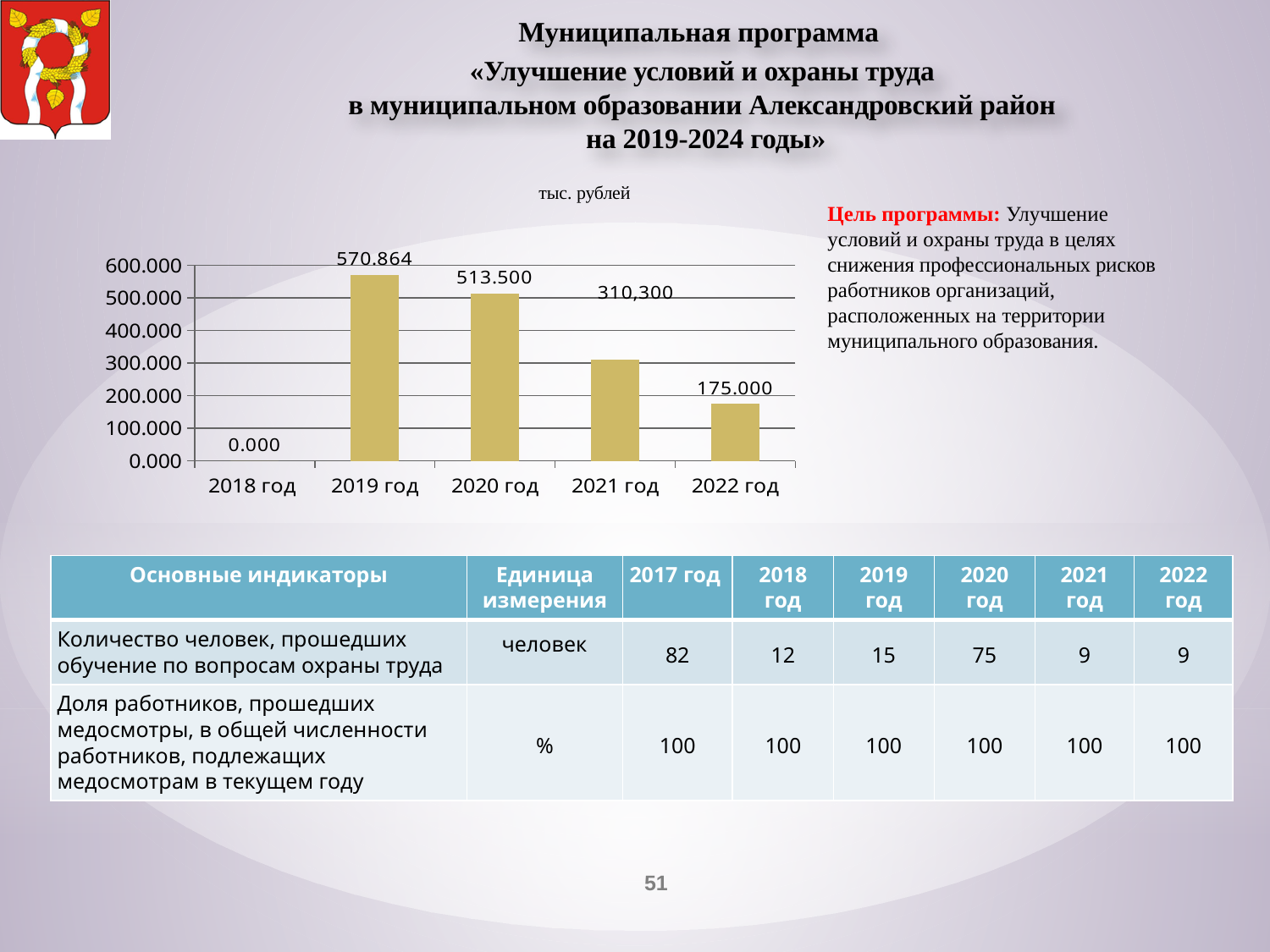
What unit is indicated above the chart? тыс. рублей How many years are shown on the x axis of the chart? 5 Which year has the highest value in the chart? 2019 год What is the value for 2019 год in the chart? 570.864 What kind of chart is shown on the slide? bar chart What is the value for 2020 год in the chart? 513.500 What is the difference between the values for 2019 год and 2020 год? 57.364 Is the value for 2022 год greater or less than 200.000? less What is the value for 2022 год in the chart? 175.000 Which year has the lowest value in the chart? 2018 год Which is larger, the value for 2020 год or the value for 2021 год? 2020 год What is the value for 2018 год in the chart? 0.000